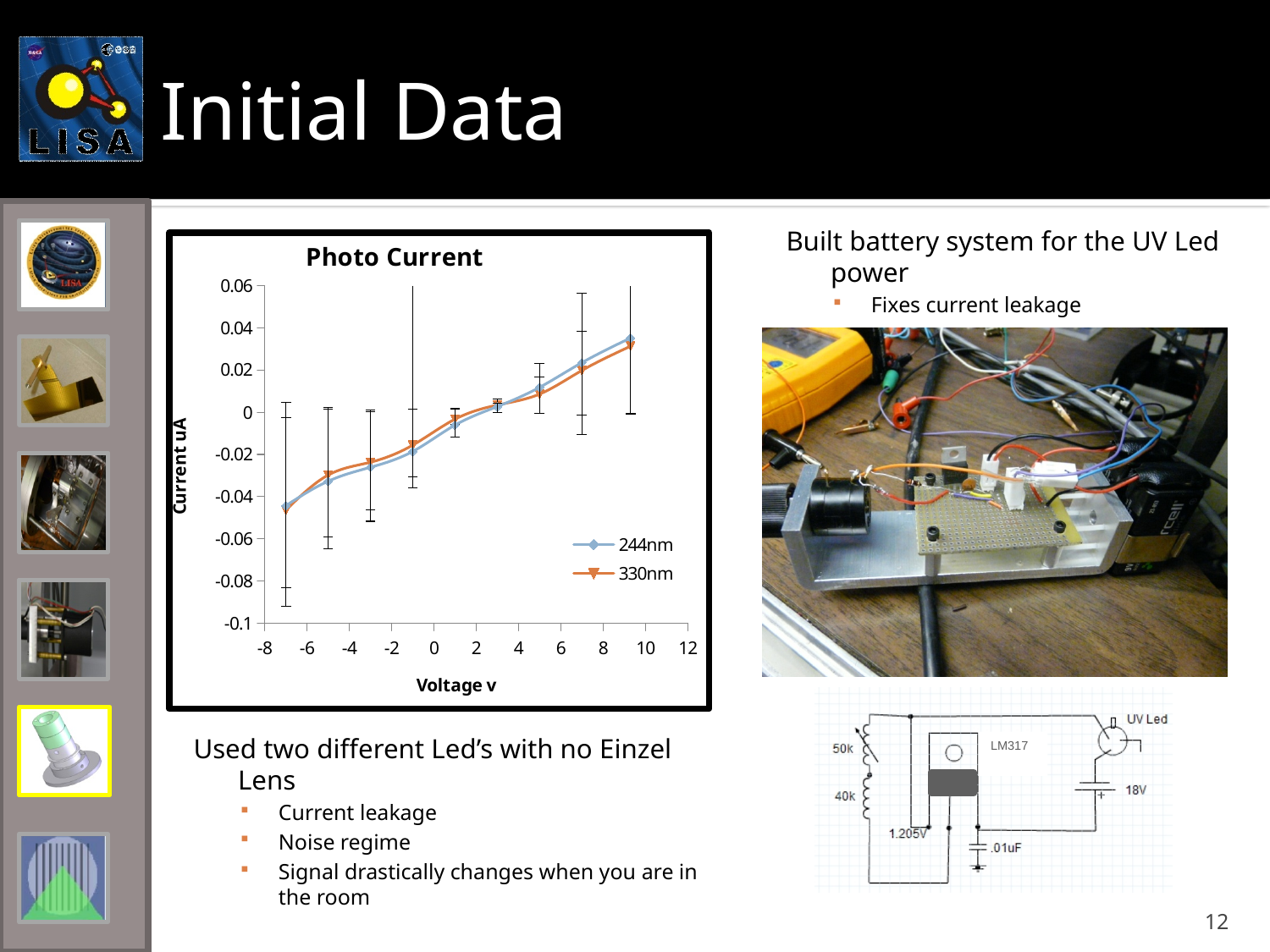
Do the current values in the Photo Current chart rise or fall as voltage increases? rise What are the two series named in the legend of the Photo Current chart? 244nm and 330nm How many series does the legend of the Photo Current chart list? 2 What is the title of the chart on the slide? Photo Current What is the label of the y axis on the Photo Current chart? Current uA What type of chart is the Photo Current chart? line chart In the Photo Current chart, is the 330nm value at a voltage of -7 greater or less than -0.02? less In the Photo Current chart, is the 330nm value at a voltage of 5 greater or less than 0.02? less At which voltage does the 330nm series have its lowest current in the Photo Current chart? -7 How many data points are plotted for the 244nm series in the Photo Current chart? 9 In the Photo Current chart, is the 244nm value at a voltage of 9 greater or less than 0.02? greater